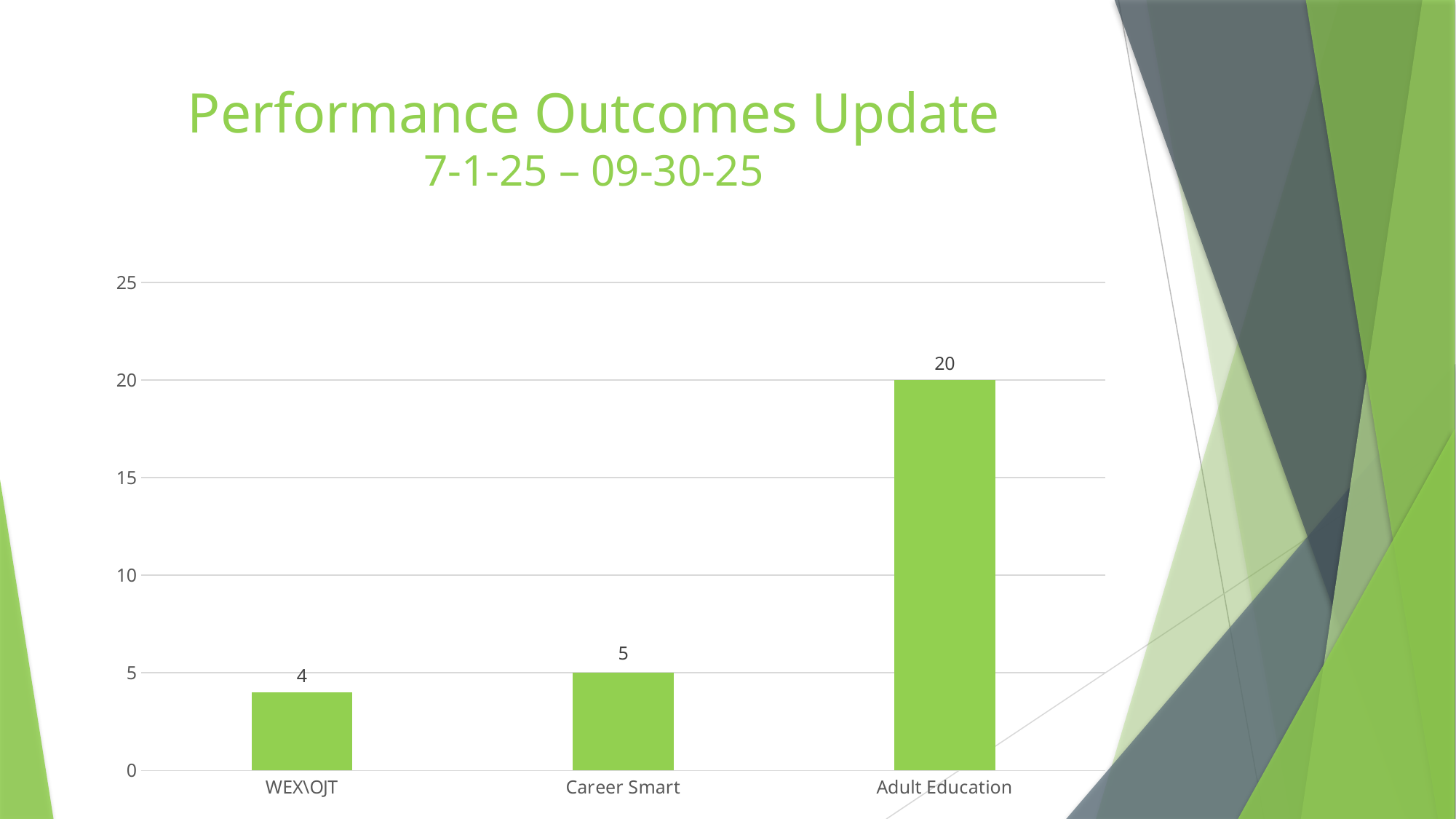
What is the value for Adult Education? 20 What is the value for Career Smart? 5 Which category has the lowest value? WEX\OJT Which category has the highest value? Adult Education Which is larger, the value for Adult Education or the value for WEX\OJT? Adult Education What is the difference between the values for Adult Education and Career Smart? 15 What kind of chart is shown on the slide? bar chart How many categories are shown on the chart? 3 What is the difference between the values for Career Smart and WEX\OJT? 1 What is the value for WEX\OJT? 4 Is the value for Adult Education greater or less than 15? greater What is the title of the slide containing the chart? Performance Outcomes Update 7-1-25 – 09-30-25